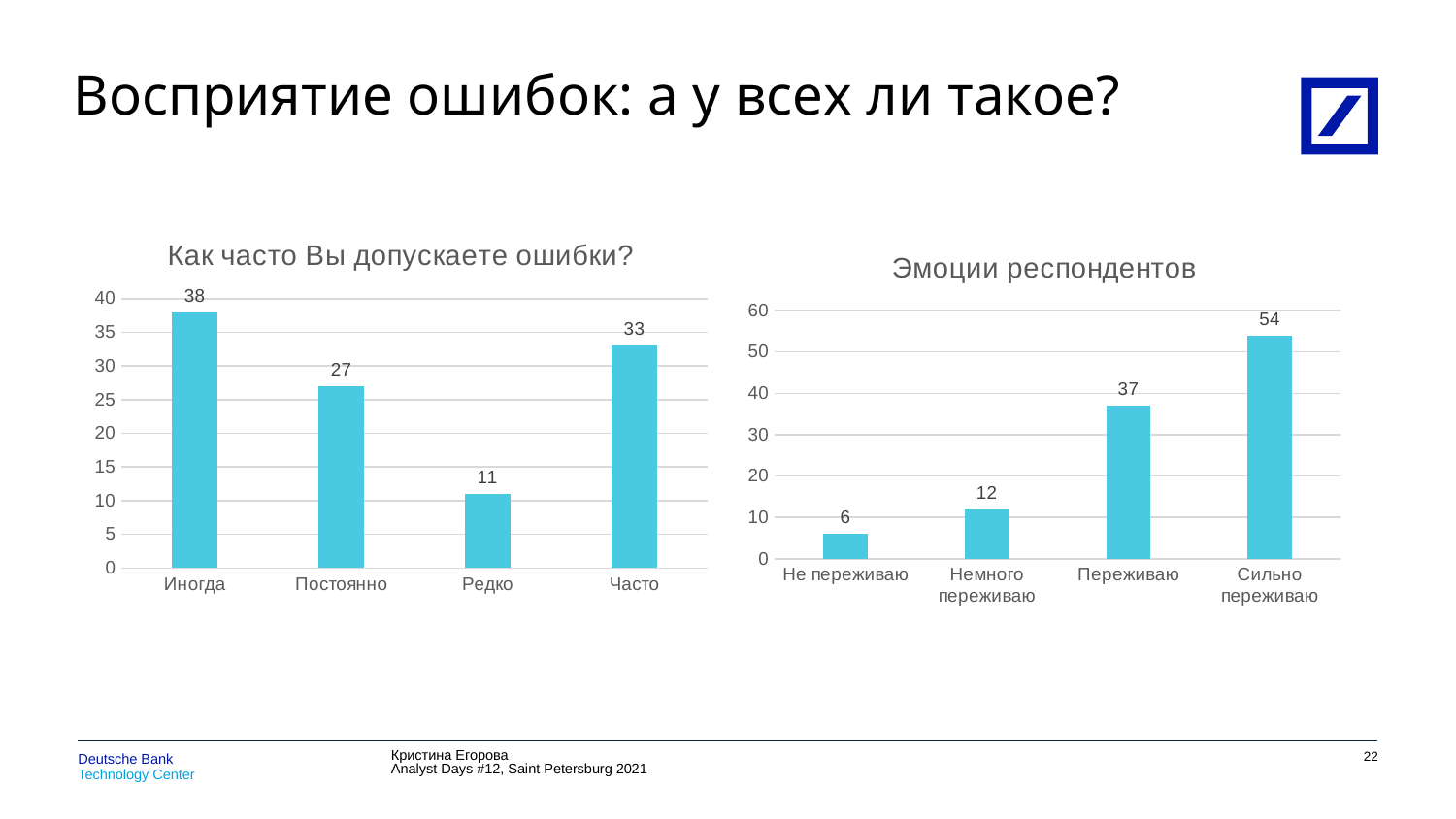
In the chart 'Эмоции респондентов', do the values rise or fall from left to right along the x axis? rise In the chart 'Как часто Вы допускаете ошибки?', what is the value for 'Иногда'? 38 In the chart 'Эмоции респондентов', what is the value for 'Немного переживаю'? 12 What type of chart is 'Эмоции респондентов'? bar chart What is the title of the chart on the left side of the slide? Как часто Вы допускаете ошибки? In the chart 'Эмоции респондентов', what is the value for 'Переживаю'? 37 In the chart 'Эмоции респондентов', what is the difference between 'Сильно переживаю' and 'Не переживаю'? 48 In the chart 'Эмоции респондентов', which category has the highest value? Сильно переживаю In the chart 'Как часто Вы допускаете ошибки?', which category has the lowest value? Редко In the chart 'Как часто Вы допускаете ошибки?', how many categories are shown? 4 In the chart 'Как часто Вы допускаете ошибки?', what is the difference between 'Иногда' and 'Часто'? 5 In the chart 'Как часто Вы допускаете ошибки?', which is larger: 'Постоянно' or 'Часто'? Часто